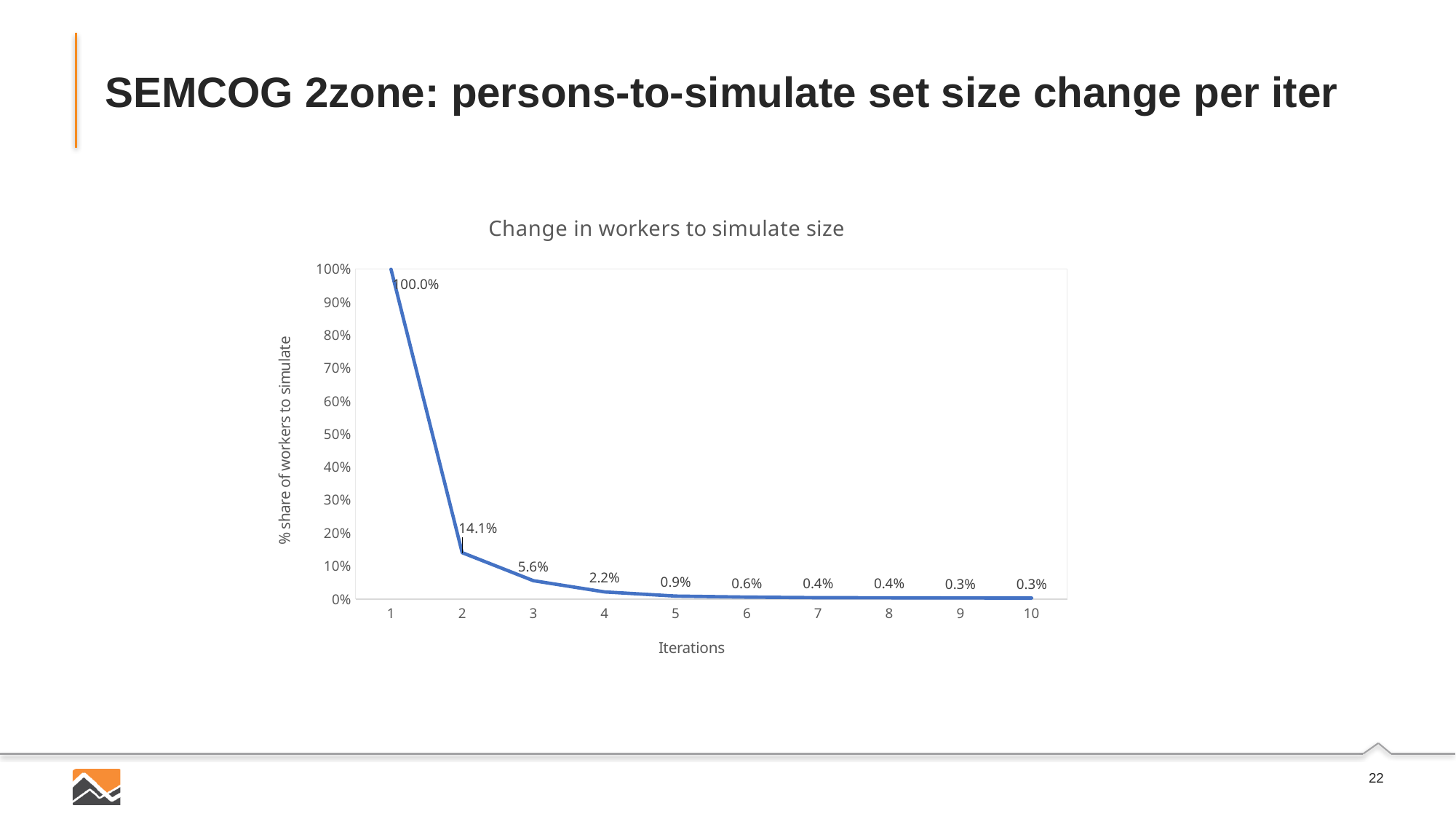
What is the value at iteration 5? 0.9% Which iteration has the highest value? 1 What is the difference between the values at iteration 2 and iteration 3? 8.5% Is the value at iteration 2 greater or less than 20%? less What kind of chart is shown? line chart What is the value at iteration 1? 100.0% Do the values rise or fall as the iterations increase? fall What is the value at iteration 10? 0.3% What is the value at iteration 3? 5.6% What is the value at iteration 2? 14.1% How many iterations are plotted on the x axis? 10 Which is larger, the value at iteration 4 or at iteration 6? iteration 4